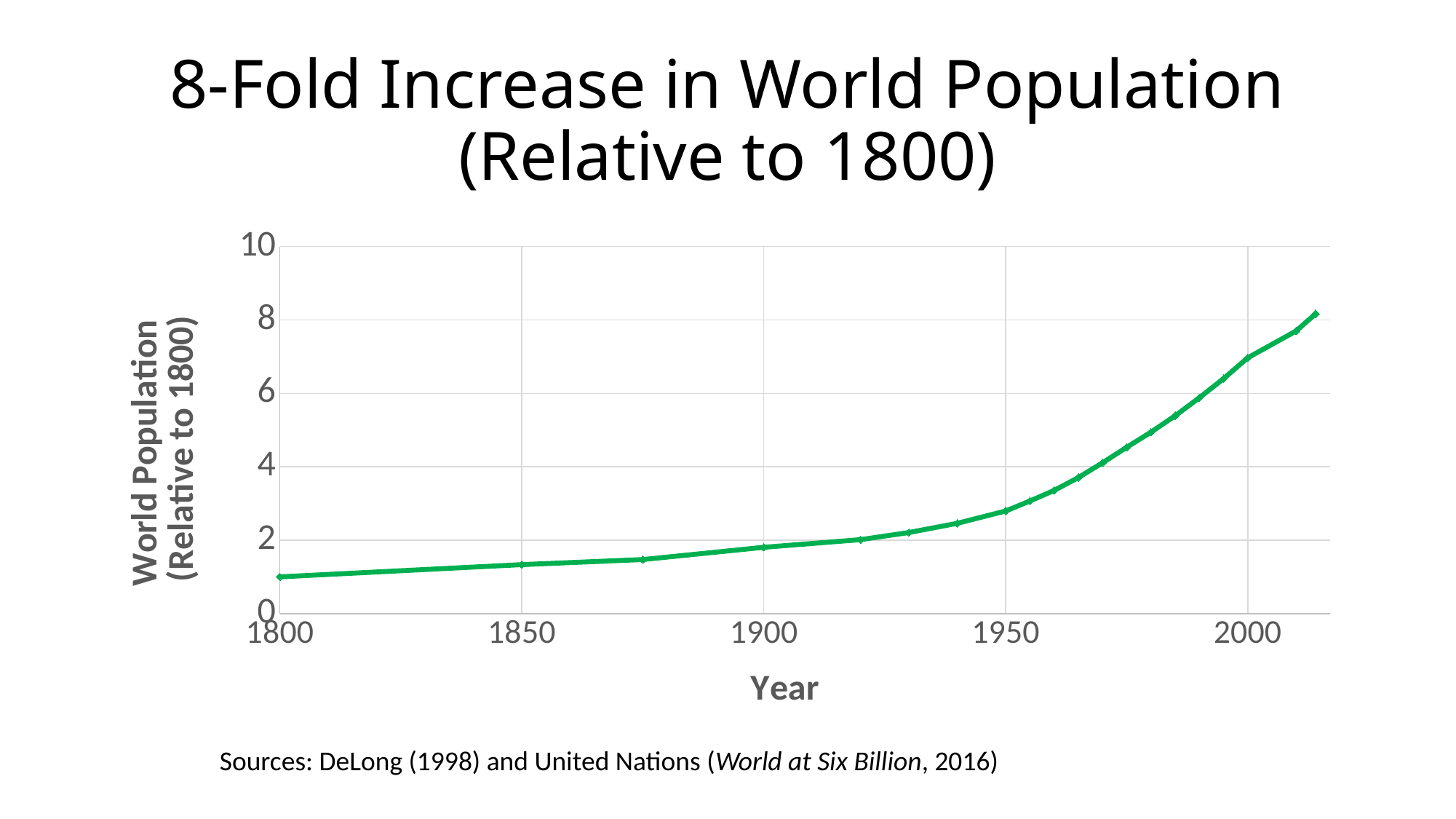
How many lines (series) are plotted on the chart? 1 Is the value for 2000 greater or less than 8? less Is the value for 1850 greater or less than 2? less Is the value for 1800 greater or less than 2? less Which year has the lowest value on the chart? 1800 What kind of chart is shown on the slide? line chart Which is larger, the value for 1900 or the value for 2000? 2000 What is the title of the chart on the slide? 8-Fold Increase in World Population (Relative to 1800) What is the label of the vertical axis? World Population (Relative to 1800) Do the values rise or fall as the year increases along the x axis? rise